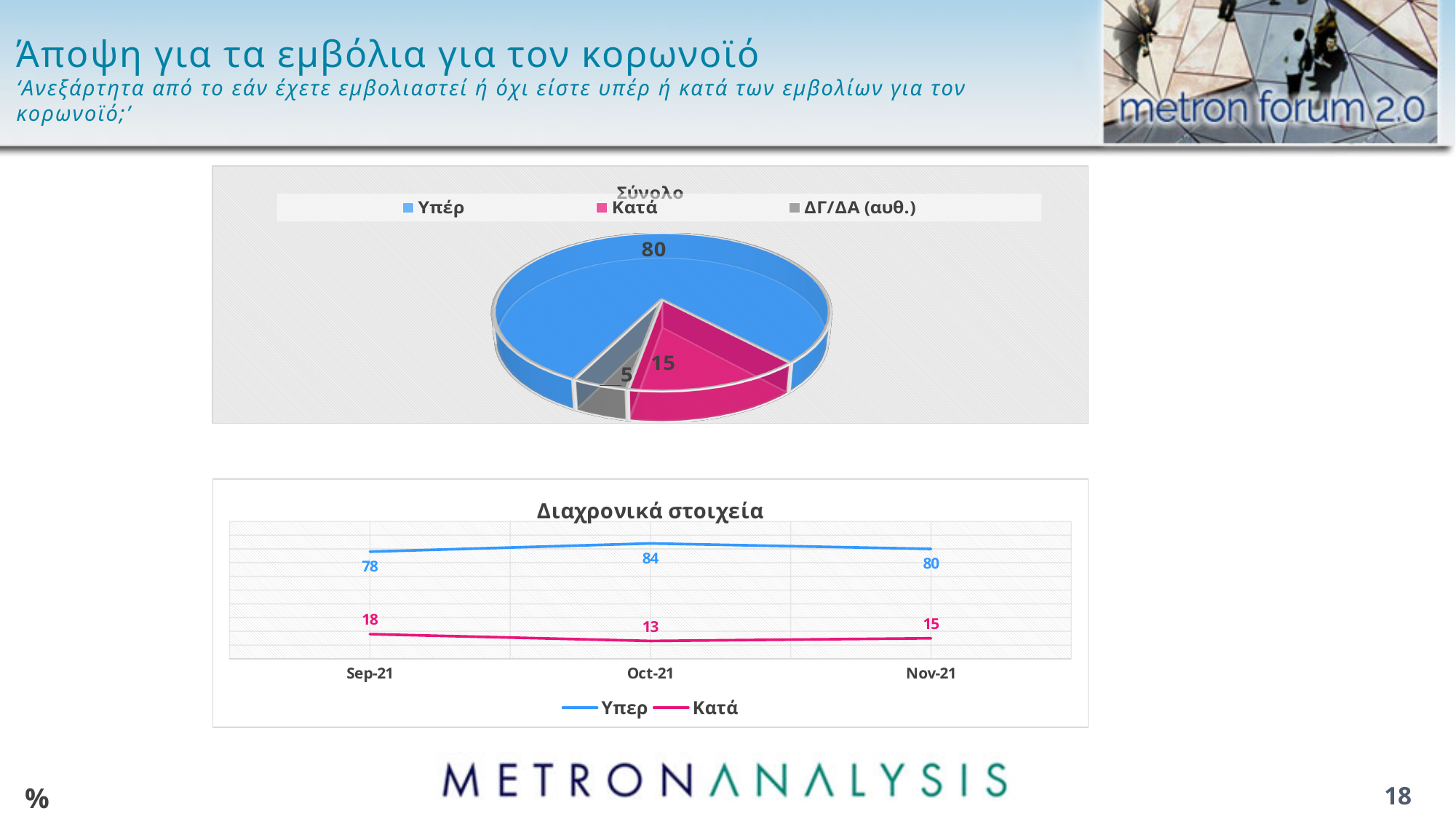
In the pie chart titled Σύνολο, how many categories does the legend list? 3 In the line chart titled Διαχρονικά στοιχεία, what is the value for Κατά in Sep-21? 18 In the pie chart titled Σύνολο, which category has the smallest slice? ΔΓ/ΔΑ (αυθ.) In the line chart titled Διαχρονικά στοιχεία, what is the difference between the Υπερ and Κατά values in Nov-21? 65 In the line chart titled Διαχρονικά στοιχεία, how many time points are shown on the x axis? 3 In the pie chart titled Σύνολο, what is the difference between the Υπέρ and Κατά values? 65 In the line chart titled Διαχρονικά στοιχεία, what is the value for Υπερ in Oct-21? 84 In the pie chart titled Σύνολο, what is the value for Υπέρ? 80 In the line chart titled Διαχρονικά στοιχεία, how many series does the legend list? 2 In the line chart titled Διαχρονικά στοιχεία, in which month is the Υπερ value highest? Oct-21 In the pie chart titled Σύνολο, what is the value for Κατά? 15 What kind of chart is the upper chart titled Σύνολο? Pie chart